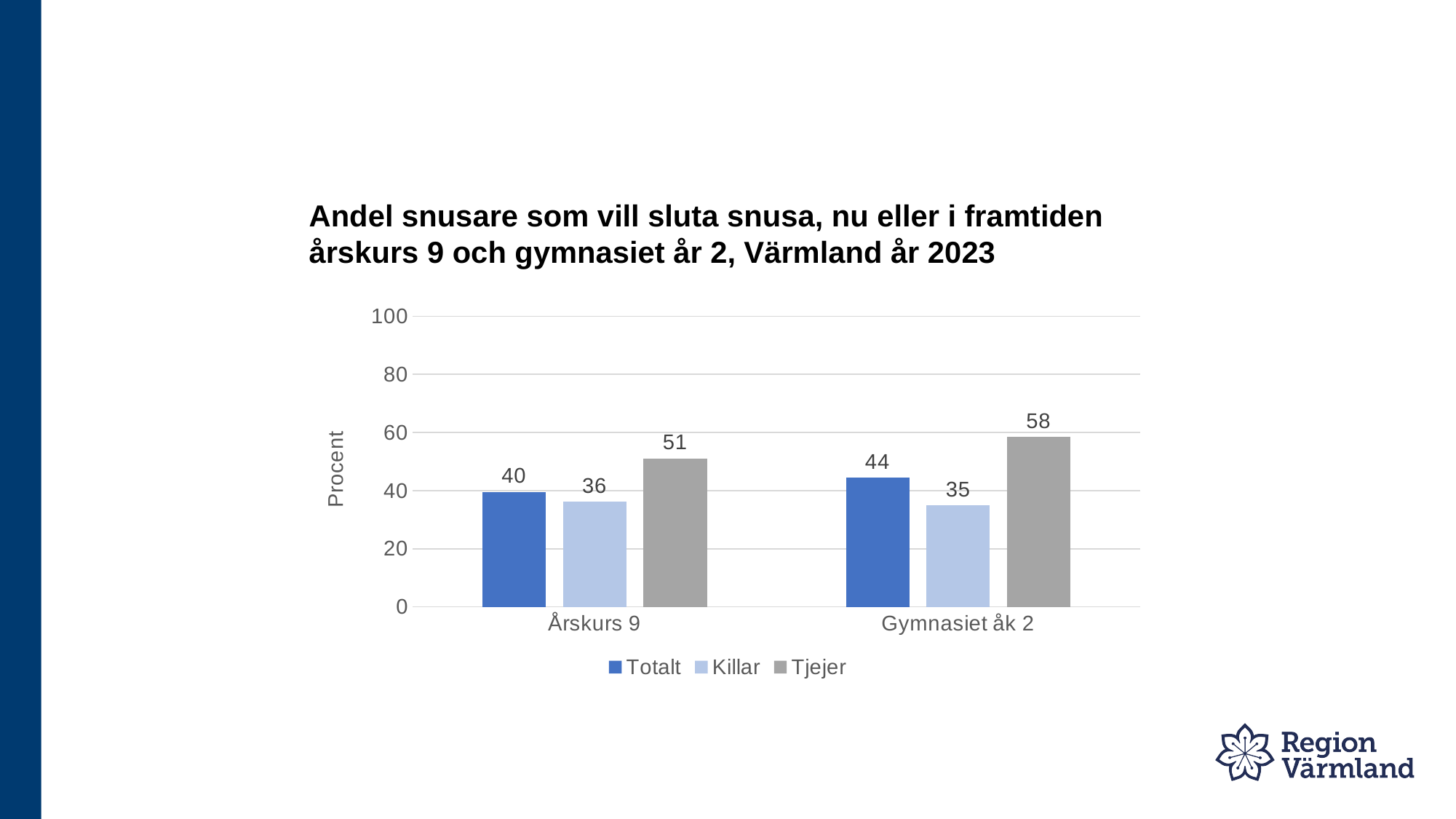
What is the difference between the Totalt values for Gymnasiet åk 2 and Årskurs 9? 4 What is the value for Tjejer in Årskurs 9? 51 What kind of chart is shown on the slide? Bar chart Is the value for Tjejer in Gymnasiet åk 2 greater or less than 40? greater Which series has the lowest value in Årskurs 9? Killar Which is larger, Tjejer in Årskurs 9 or Tjejer in Gymnasiet åk 2? Tjejer in Gymnasiet åk 2 What is the value for Totalt in Gymnasiet åk 2? 44 How many series does the legend list? 3 What is the difference between Tjejer and Killar in Gymnasiet åk 2? 23 What is the value for Killar in Gymnasiet åk 2? 35 What is the label of the vertical axis? Procent Which series has the highest value in Gymnasiet åk 2? Tjejer